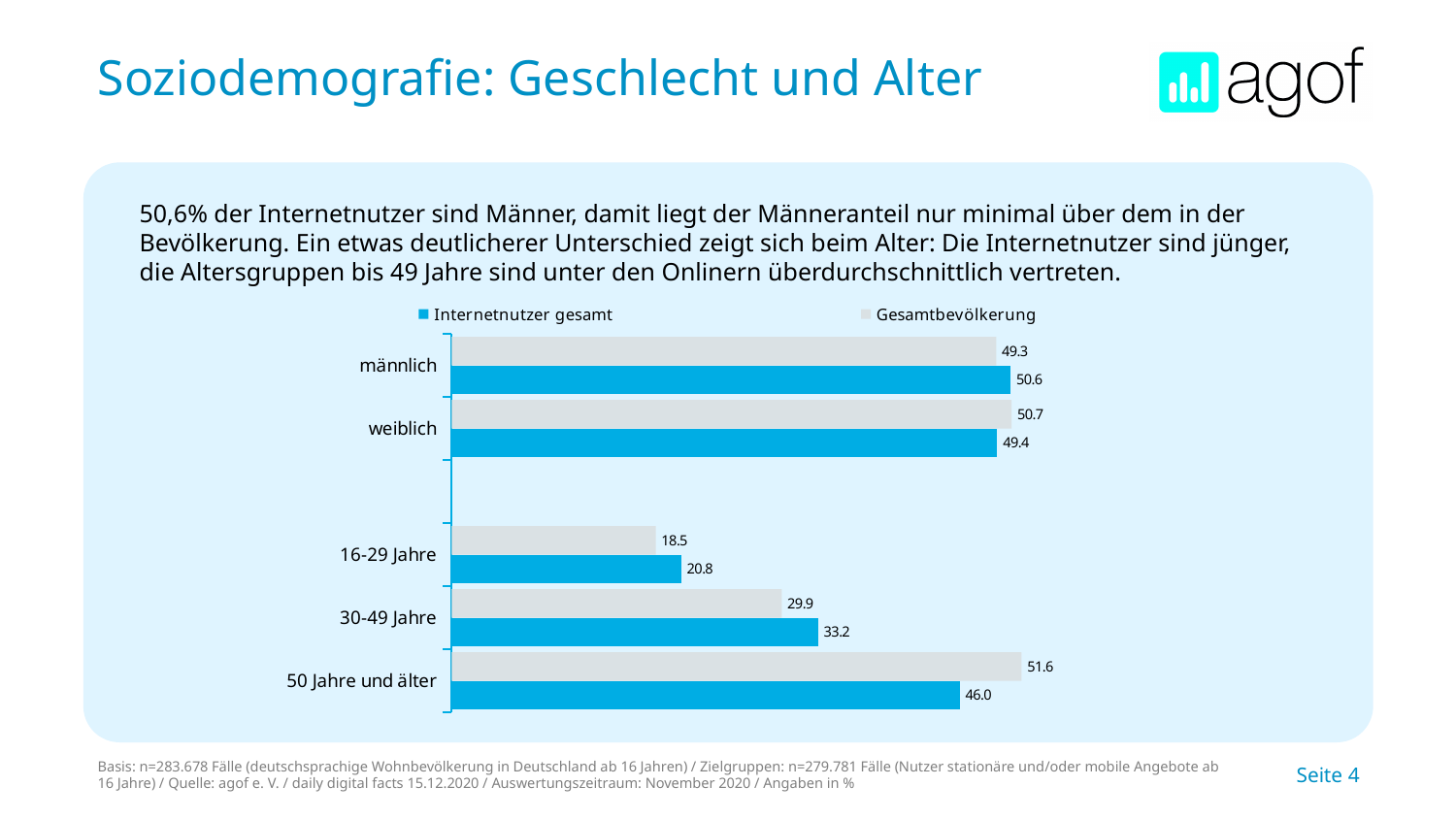
For '16-29 Jahre', which series has the larger value: 'Internetnutzer gesamt' or 'Gesamtbevölkerung'? Internetnutzer gesamt What kind of chart is shown on the slide? Bar chart Which age group has the lowest value in the 'Gesamtbevölkerung' series? 16-29 Jahre What is the value for '16-29 Jahre' in the 'Internetnutzer gesamt' series? 20.8 How many series does the legend list? 2 How many categories are shown on the chart? 5 What is the difference between 'Internetnutzer gesamt' and 'Gesamtbevölkerung' for '30-49 Jahre'? 3.3 Which age group has the highest value in the 'Internetnutzer gesamt' series? 50 Jahre und älter What is the value for 'männlich' in the 'Internetnutzer gesamt' series? 50.6 What is the value for '50 Jahre und älter' in the 'Gesamtbevölkerung' series? 51.6 What is the difference between 'Gesamtbevölkerung' and 'Internetnutzer gesamt' for '50 Jahre und älter'? 5.6 What is the value for 'weiblich' in the 'Gesamtbevölkerung' series? 50.7